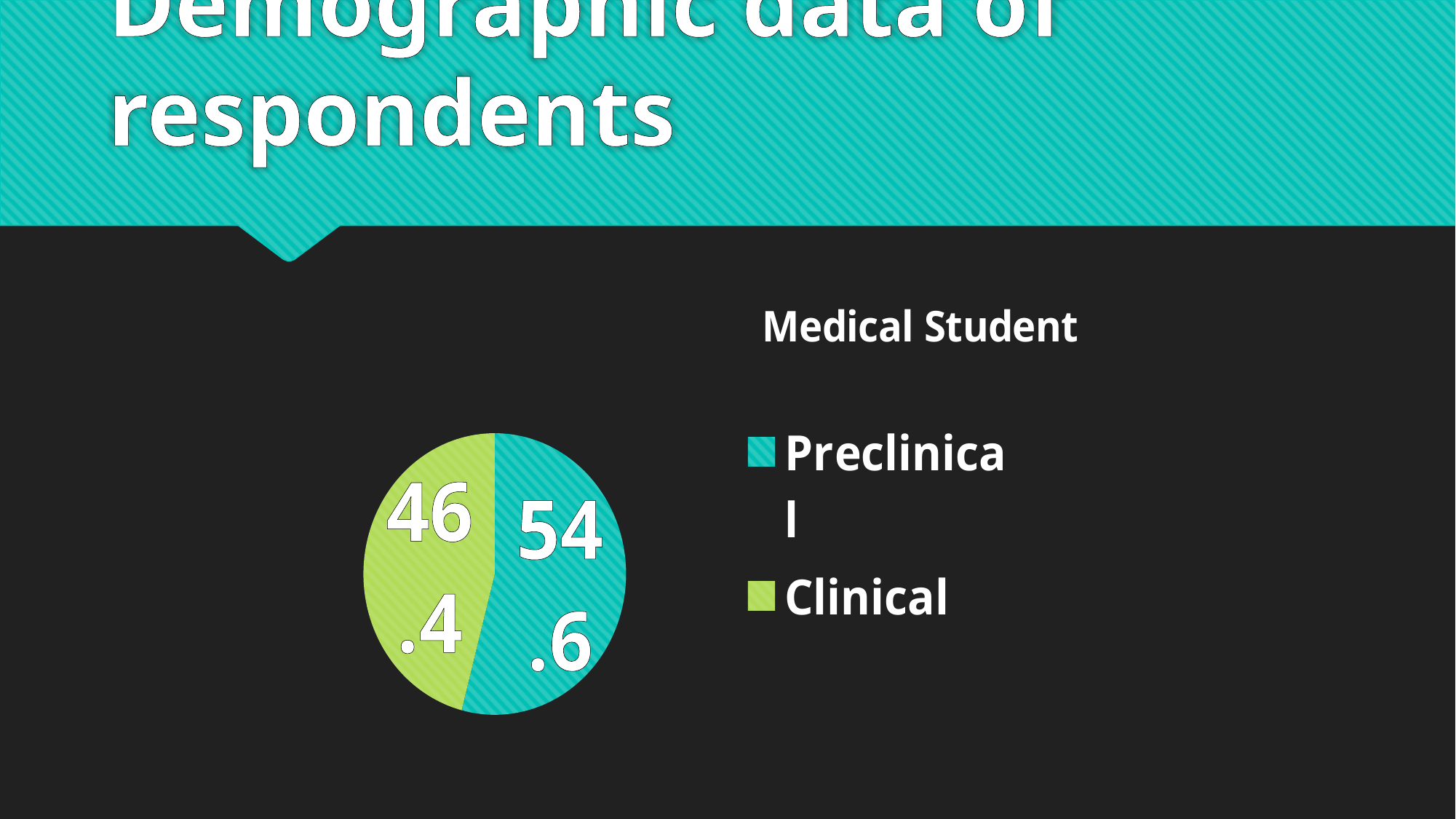
In the Medical Student pie chart, which is larger: Preclinical or Clinical? Preclinical Which slice of the Medical Student pie chart is the smallest? Clinical Which colour represents the Clinical slice in the Medical Student pie chart? Green What is the difference between the Preclinical and Clinical values in the Medical Student pie chart? 8.2 What kind of chart is shown on the slide? Pie chart Which slice of the Medical Student pie chart is the largest? Preclinical How many entries does the legend of the Medical Student chart list? 2 What is the value shown for the Clinical slice of the Medical Student pie chart? 46.4 What is the title of the chart on the slide? Medical Student How many slices does the Medical Student pie chart have? 2 What is the value shown for the Preclinical slice of the Medical Student pie chart? 54.6